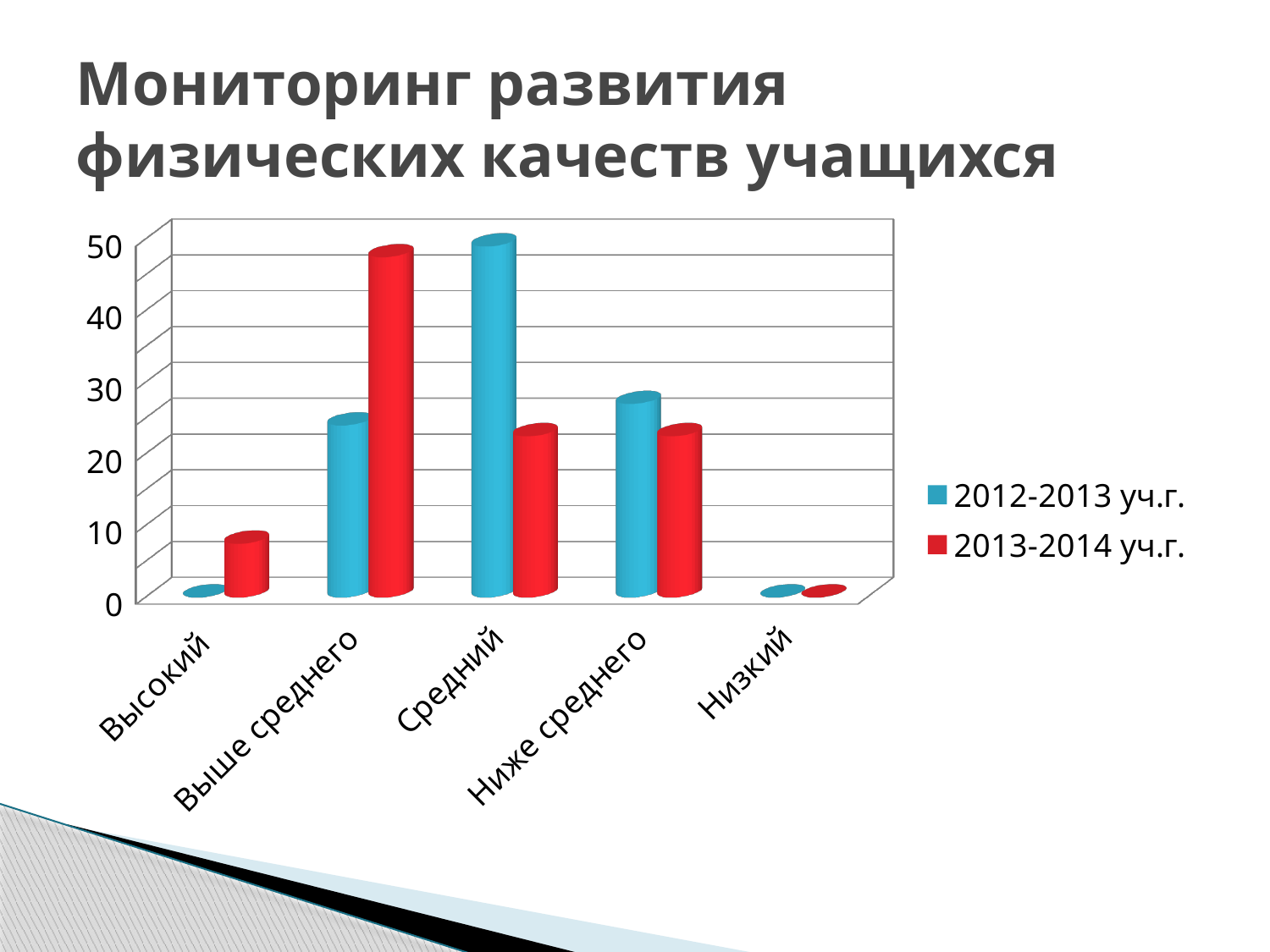
What colour represents the 2013-2014 уч.г. series? Red Which category has the highest value for the 2013-2014 уч.г. series? Выше среднего What kind of chart is shown on the slide? Bar chart For the Выше среднего category, which series has the larger value, 2012-2013 уч.г. or 2013-2014 уч.г.? 2013-2014 уч.г. Is the value for Высокий in 2013-2014 уч.г. greater or less than 10? less For the Средний category, which series has the larger value, 2012-2013 уч.г. or 2013-2014 уч.г.? 2012-2013 уч.г. Is the value for Средний in 2012-2013 уч.г. greater or less than 40? greater Is the value for Средний in 2013-2014 уч.г. greater or less than 30? less Which category has the highest value for the 2012-2013 уч.г. series? Средний How many categories are shown on the x axis? 5 How many series does the legend list? 2